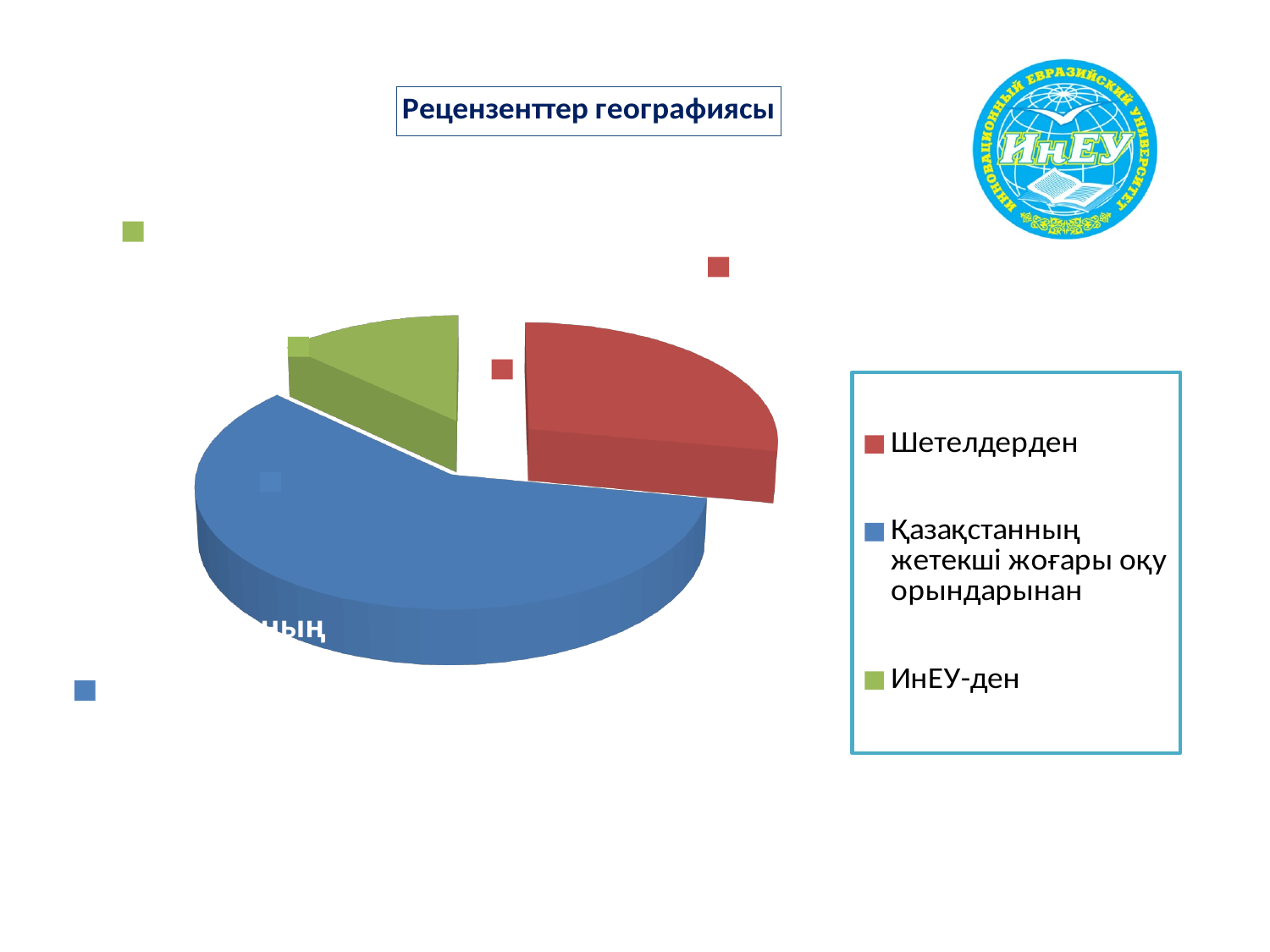
Which category has the smallest slice of the pie? ИнЕУ-ден What colour is the slice for ИнЕУ-ден? green How many slices does the pie chart have? 3 What is the title of the chart? Рецензенттер географиясы How many entries does the legend list? 3 What kind of chart is shown on the slide? pie chart Which category has the largest slice of the pie? Қазақстанның жетекші жоғары оқу орындарынан Which slice is larger: Қазақстанның жетекші жоғары оқу орындарынан or Шетелдерден? Қазақстанның жетекші жоғары оқу орындарынан Which slice is larger: Шетелдерден or ИнЕУ-ден? Шетелдерден